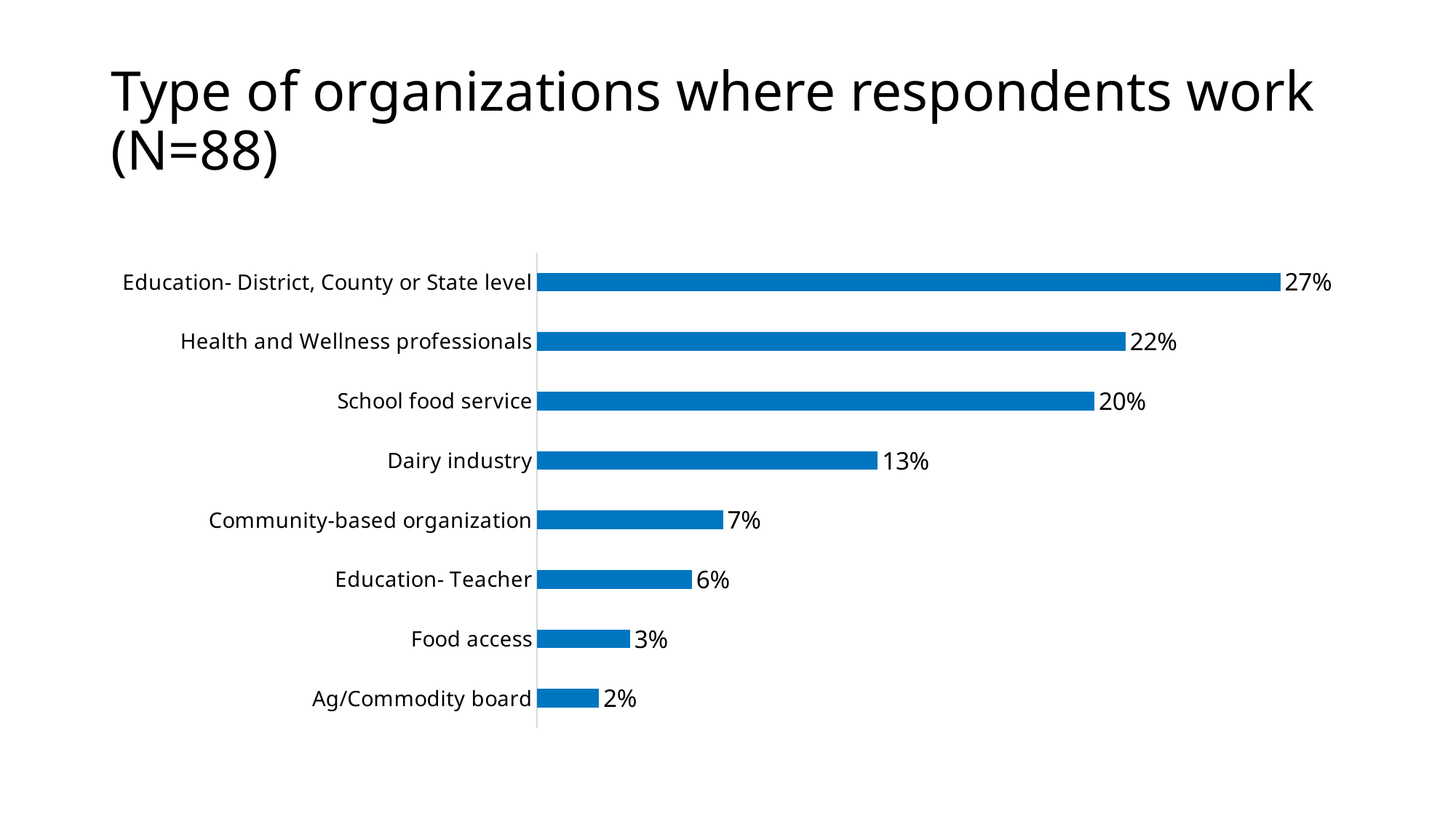
What kind of chart is shown on the slide? Bar chart How many organization types are shown in the chart? 8 What is the value for Dairy industry? 13% What is the difference between Dairy industry and Community-based organization? 6% What percentage of respondents work in Education- District, County or State level? 27% Which is larger, Education- Teacher or Food access? Education- Teacher Which organization type has the highest percentage of respondents? Education- District, County or State level What percentage of respondents work in School food service? 20% What is the difference between Health and Wellness professionals and School food service? 2% Which organization type has the lowest percentage of respondents? Ag/Commodity board What is the title of the slide? Type of organizations where respondents work (N=88) What is the value for Ag/Commodity board? 2%